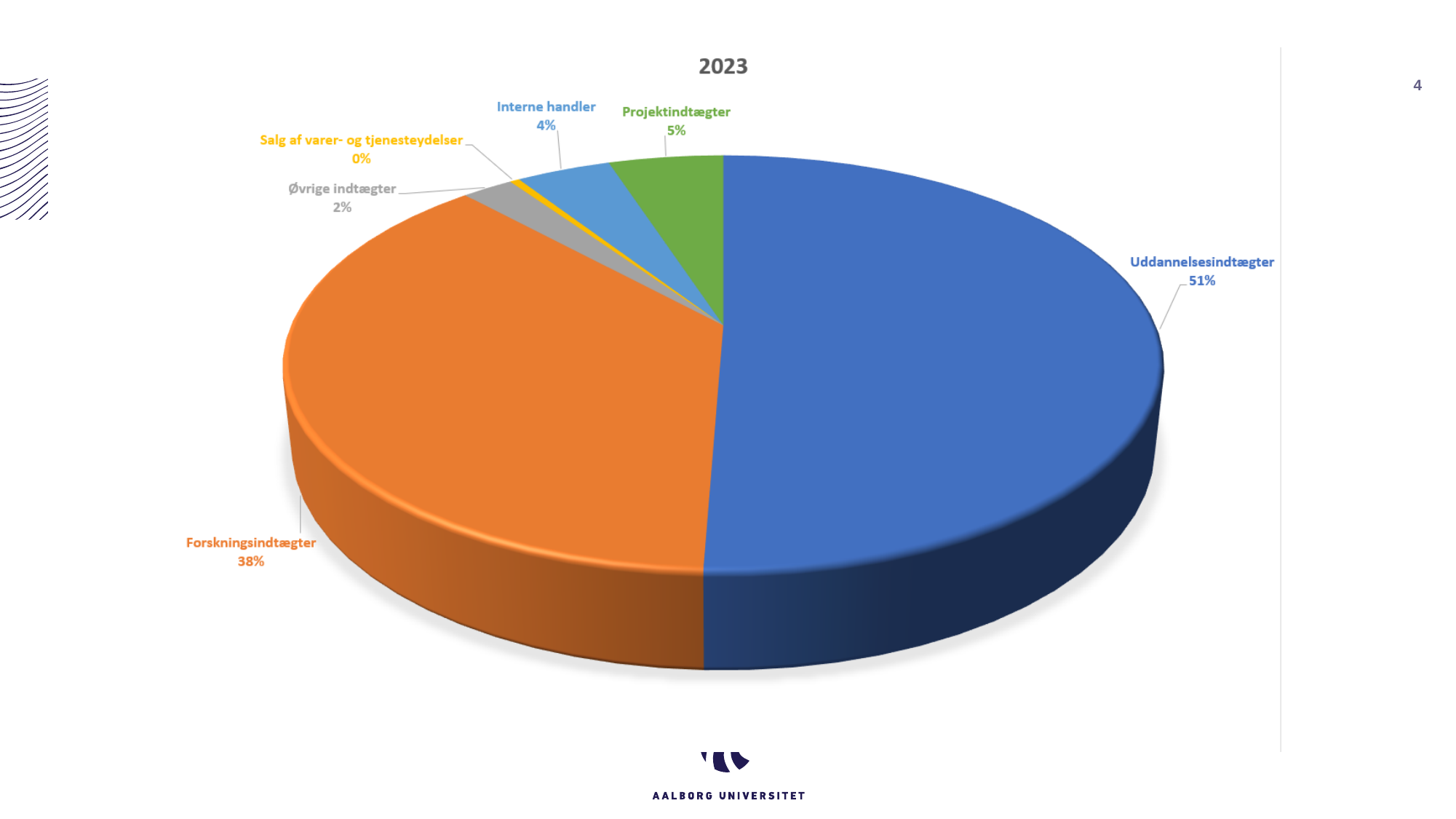
What share of the pie is Salg af varer- og tjenesteydelser? 0% What is the difference in percentage points between Uddannelsesindtægter and Forskningsindtægter? 13 How many categories are shown in the pie chart? 6 What kind of chart is shown on the slide? Pie chart Which category has the smallest share of the pie? Salg af varer- og tjenesteydelser What is the title of the chart? 2023 Which category has the largest share of the pie? Uddannelsesindtægter What share of the pie is Projektindtægter? 5% What share of the pie is Uddannelsesindtægter? 51% What share of the pie is Forskningsindtægter? 38% What share of the pie is Øvrige indtægter? 2% What share of the pie is Interne handler? 4%